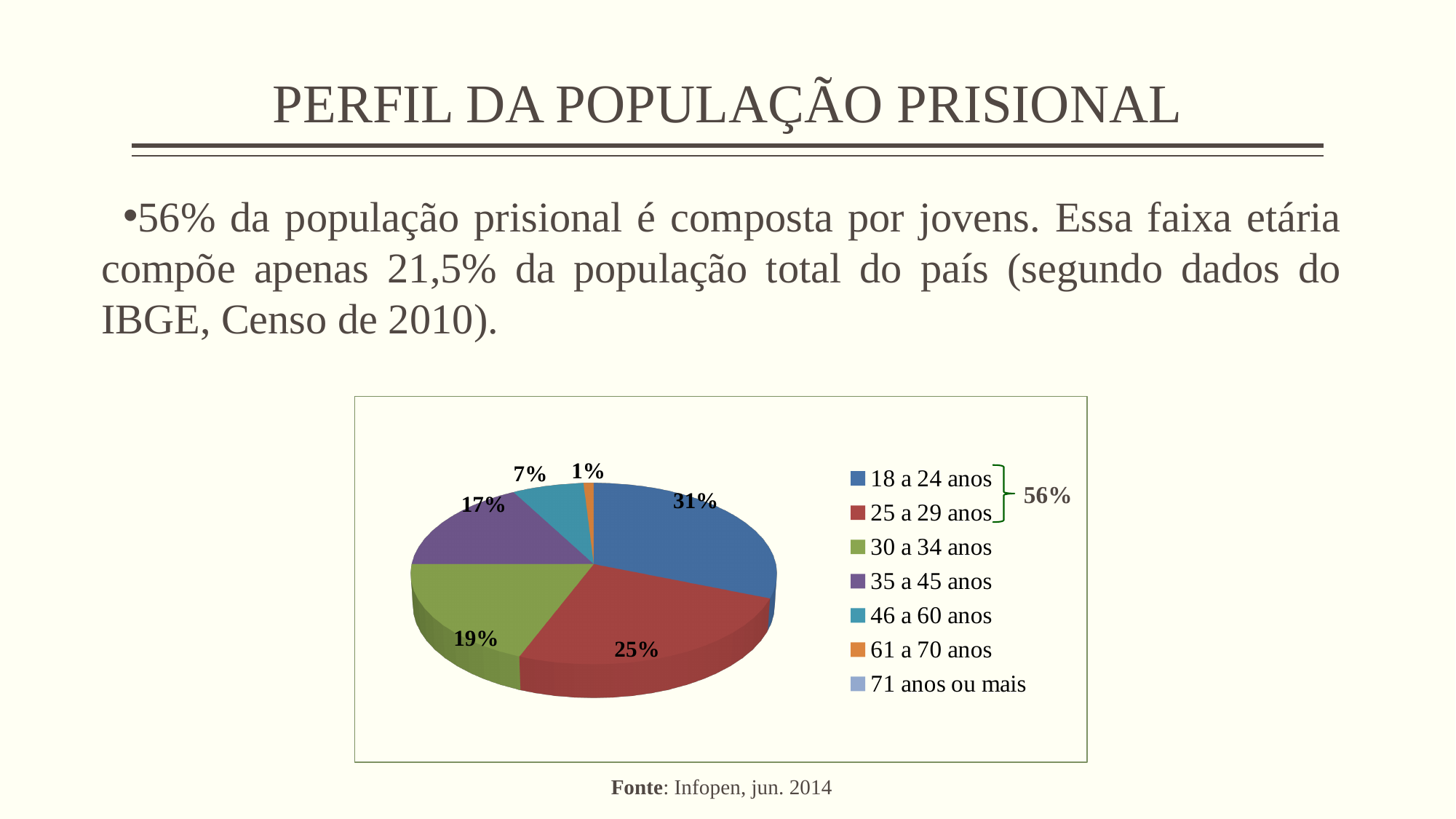
What share of the pie does the "30 a 34 anos" slice represent? 19% What share of the pie does the "46 a 60 anos" slice represent? 7% What share of the pie does the "18 a 24 anos" slice represent? 31% What kind of chart is shown on the slide? pie chart What share of the pie does the "61 a 70 anos" slice represent? 1% What share of the pie does the "35 a 45 anos" slice represent? 17% What combined percentage is marked by the bracket next to the "18 a 24 anos" and "25 a 29 anos" legend entries? 56% How many entries does the chart legend list? 7 What share of the pie does the "25 a 29 anos" slice represent? 25% Which of the two slices is larger, "30 a 34 anos" or "35 a 45 anos"? 30 a 34 anos What is the difference in percentage points between the "18 a 24 anos" slice and the "25 a 29 anos" slice? 6% Which age group has the largest slice of the pie? 18 a 24 anos